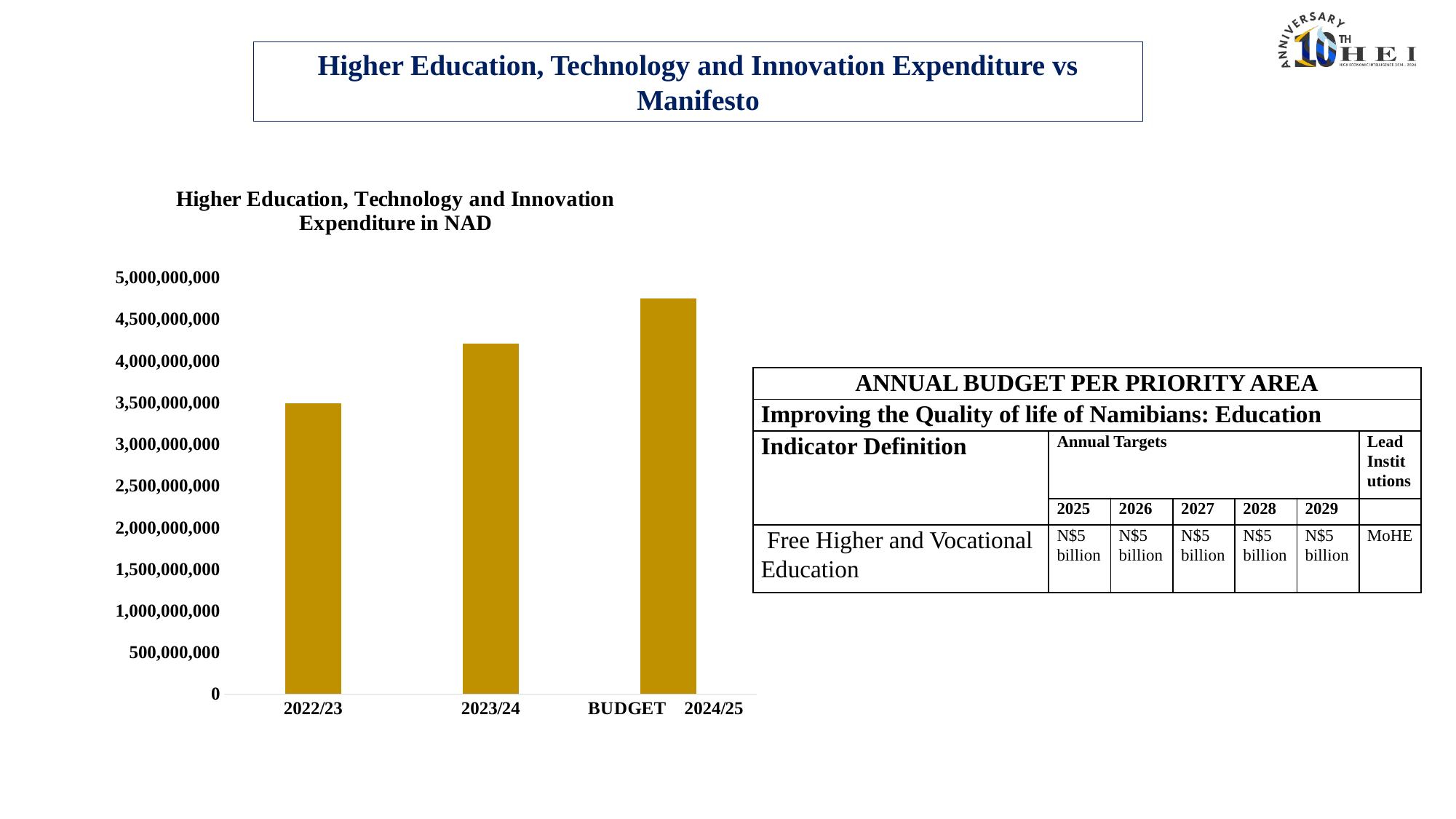
What kind of chart is shown on the slide? bar chart Do the values rise or fall from 2022/23 to BUDGET 2024/25? rise Is the expenditure for 2022/23 greater or less than 4,000,000,000? less How many bars (categories) does the chart show? 3 Is the expenditure for 2023/24 greater or less than 4,500,000,000? less Which category has the lowest expenditure in the chart? 2022/23 Is the value for BUDGET 2024/25 greater or less than 5,000,000,000? less Which category has the highest expenditure in the chart? BUDGET 2024/25 What is the title of the chart? Higher Education, Technology and Innovation Expenditure in NAD Which is larger, the expenditure for 2022/23 or for 2023/24? 2023/24